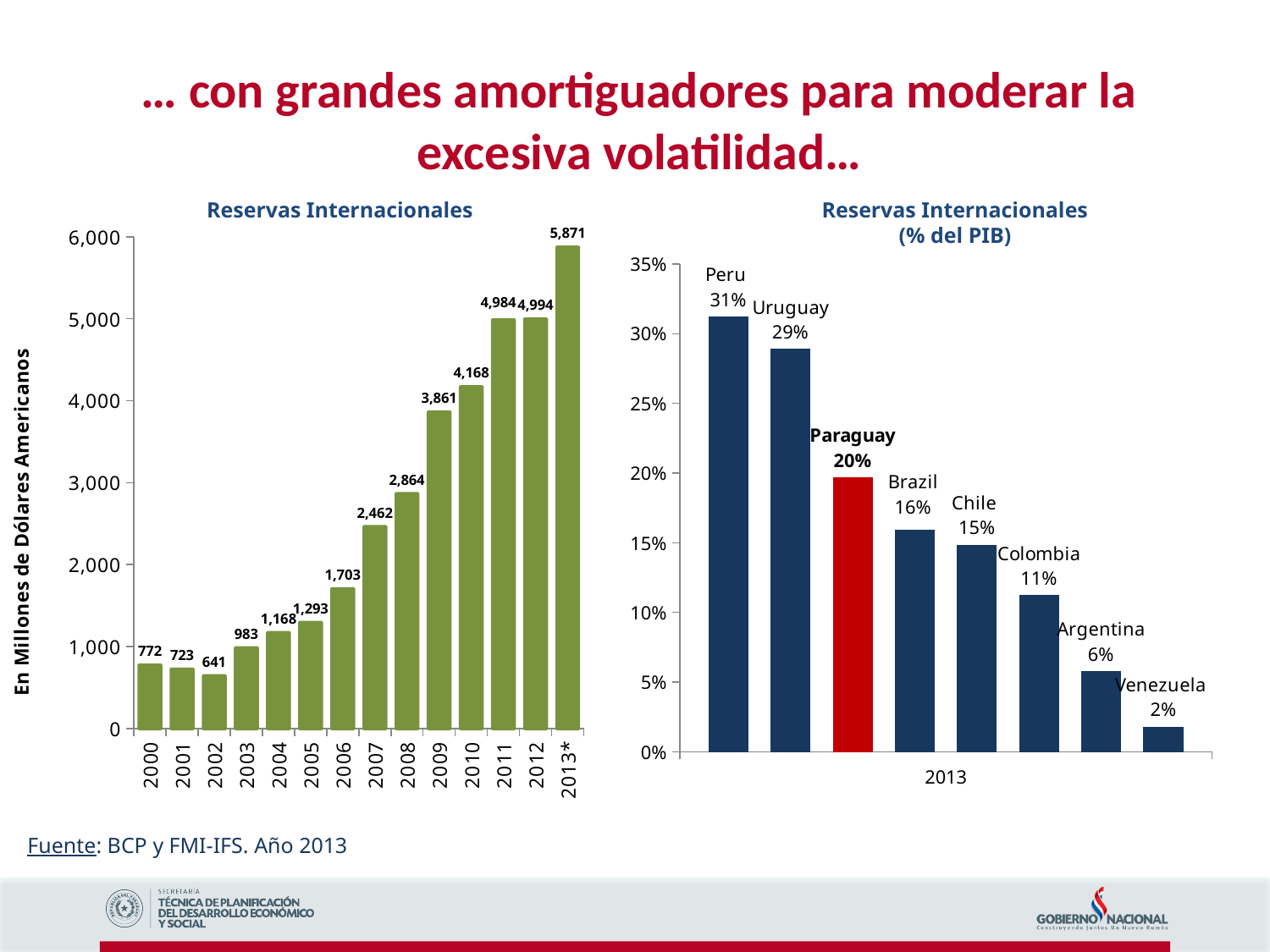
In the 'Reservas Internacionales' chart on the left, how many years are shown on the x axis? 14 In the 'Reservas Internacionales' chart on the left, what is the difference between the values for 2013* and 2012? 877 In the 'Reservas Internacionales (% del PIB)' chart on the right, which country's bar is coloured red? Paraguay In the 'Reservas Internacionales' chart on the left, which year has the lowest value? 2002 In the 'Reservas Internacionales' chart on the left, what is the value for 2008? 2,864 In the 'Reservas Internacionales' chart on the left, which year has the highest value? 2013* In the 'Reservas Internacionales (% del PIB)' chart on the right, how many countries are shown? 8 In the 'Reservas Internacionales (% del PIB)' chart on the right, which country has the lowest value? Venezuela In the 'Reservas Internacionales' chart on the left, what is the y-axis label? En Millones de Dólares Americanos In the 'Reservas Internacionales (% del PIB)' chart on the right, which country has the highest value? Peru In the 'Reservas Internacionales (% del PIB)' chart on the right, which is larger, the value for Paraguay or the value for Brazil? Paraguay In the 'Reservas Internacionales (% del PIB)' chart on the right, what is the value for Chile? 15%